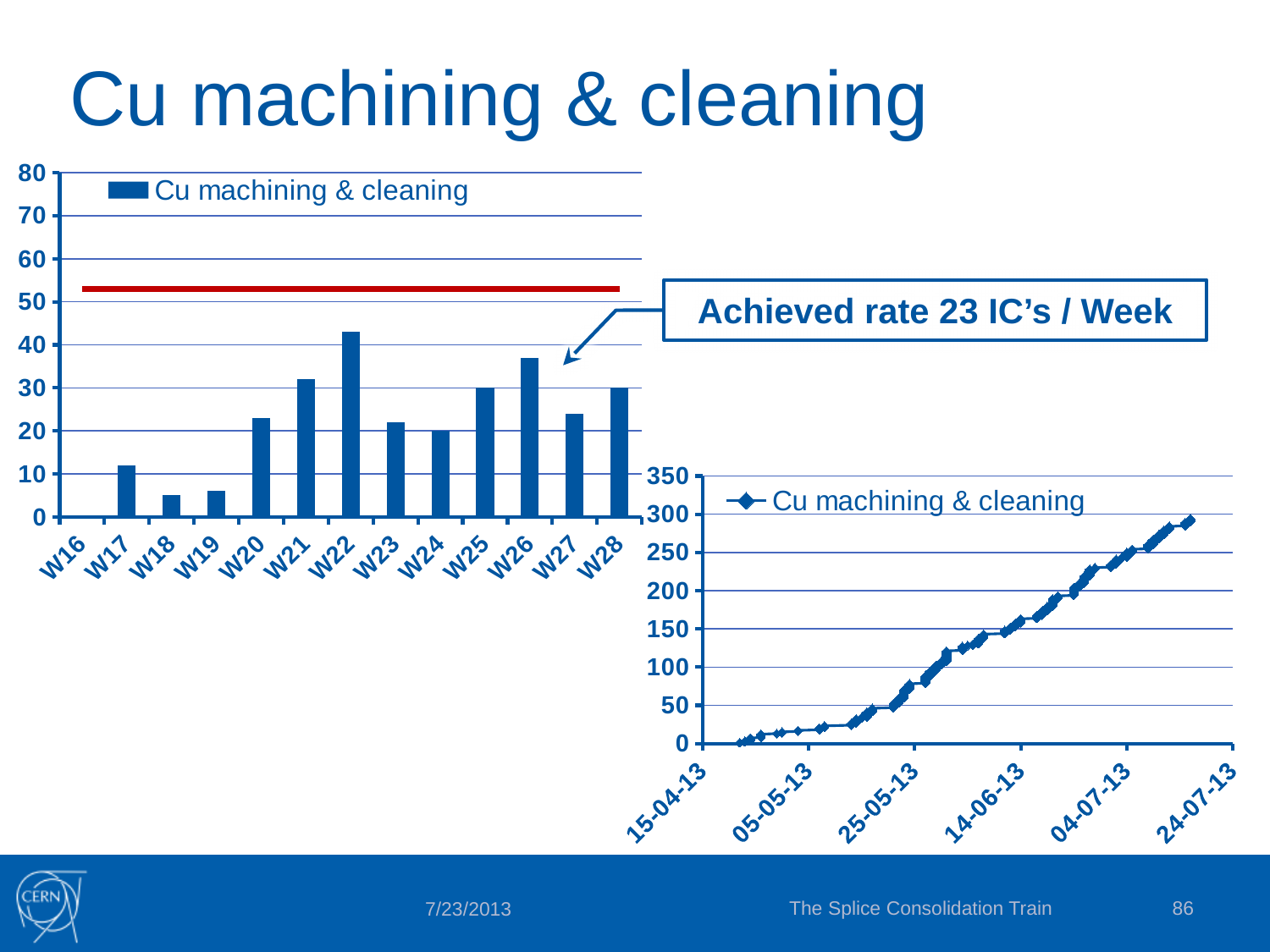
What kind of chart is the chart on the left of the slide (weeks W16 to W28)? bar chart In the bar chart on the left, which week has the highest value? W22 In the line chart on the lower right, is the last plotted value (near 24-07-13) greater or less than 250? greater In the bar chart on the left, is the value for W22 greater or less than 40? greater In the bar chart on the left, which is larger, the value for W21 or the value for W23? W21 In the bar chart on the left, is the value for W26 greater or less than 30? greater In the line chart on the lower right, do the values rise or fall along the x axis? rise In the bar chart on the left, how many weeks are shown on the x axis? 13 What kind of chart is the chart on the lower right of the slide (dates from 15-04-13 to 24-07-13)? line chart What achieved rate does the annotation on the bar chart state? 23 IC's / Week